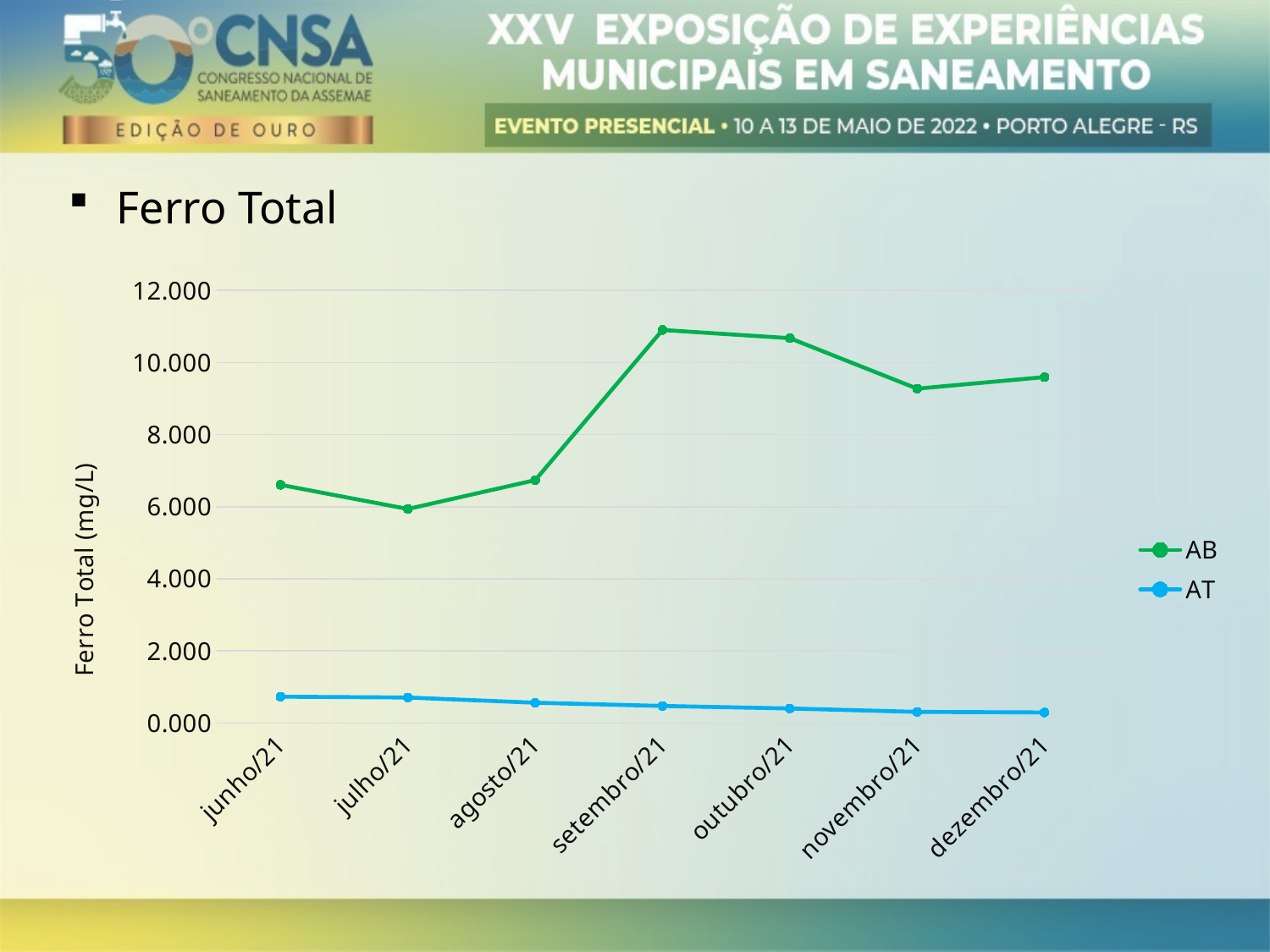
How many months are plotted along the x axis? 7 Is the value for AT in dezembro/21 greater or less than 2.000? less What is the label of the vertical axis? Ferro Total (mg/L) Is the value for AB in novembro/21 greater or less than 10.000? less Which month has the lowest value for the AB series? julho/21 Which series has the larger value in outubro/21, AB or AT? AB Is the value for AB in setembro/21 greater or less than 10.000? greater What kind of chart is shown on the slide? line chart Does the AT series rise or fall from junho/21 to dezembro/21? fall Which series is drawn in green? AB How many series does the legend list? 2